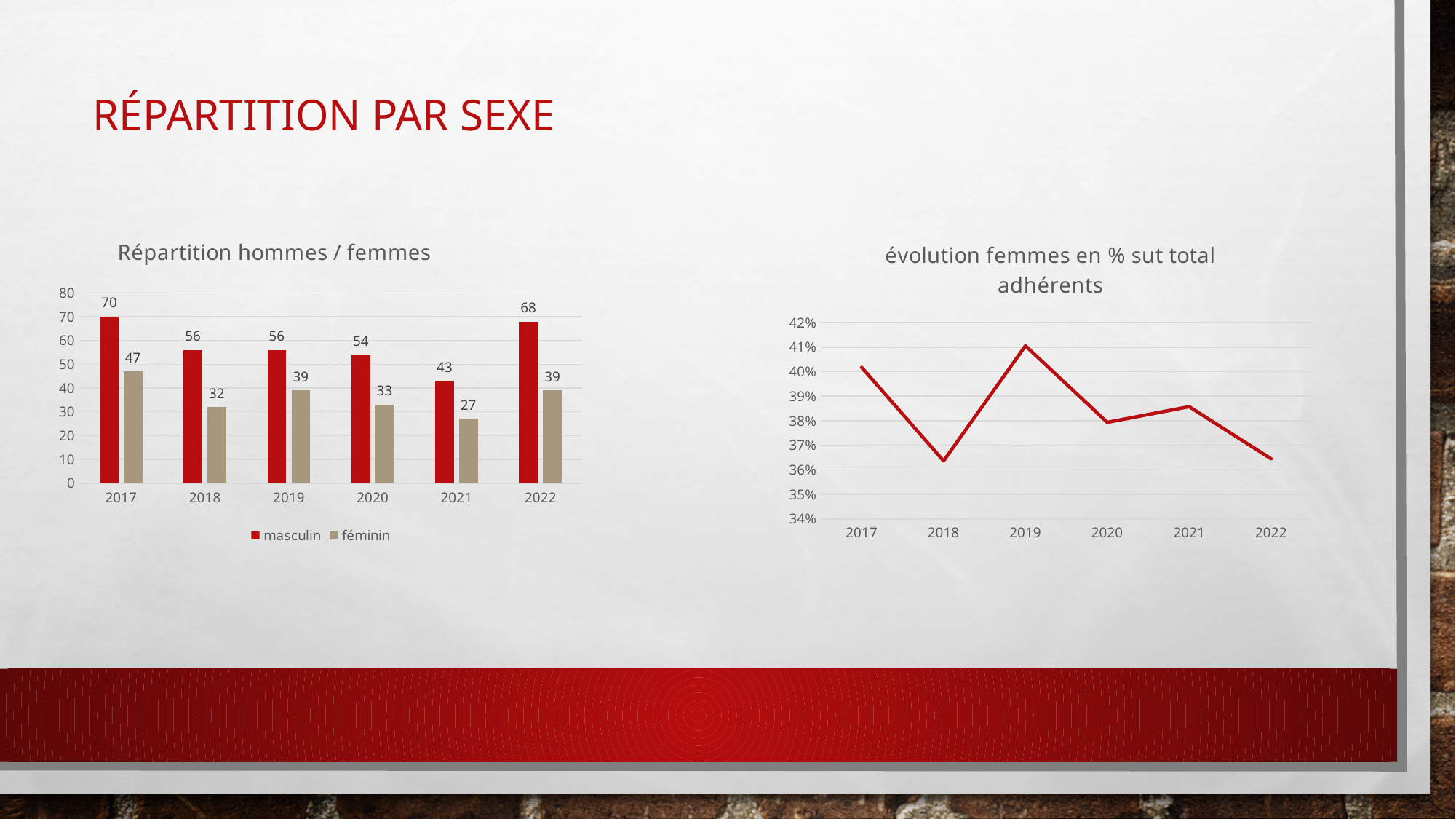
In the 'Répartition hommes / femmes' chart, how many series does the legend list? 2 In the 'évolution femmes en % sut total adhérents' chart, which year has the highest value? 2019 In the 'Répartition hommes / femmes' chart, what is the value for masculin in 2017? 70 In the 'Répartition hommes / femmes' chart, what is the value for féminin in 2021? 27 In the 'Répartition hommes / femmes' chart, which year has the lowest masculin value? 2021 In the 'Répartition hommes / femmes' chart, how many years are shown on the x axis? 6 In the 'Répartition hommes / femmes' chart, which is larger: féminin in 2019 or féminin in 2020? féminin in 2019 What kind of chart is 'évolution femmes en % sut total adhérents'? line chart In the 'évolution femmes en % sut total adhérents' chart, is the value for 2019 greater or less than 40%? greater In the 'évolution femmes en % sut total adhérents' chart, does the value rise or fall from 2019 to 2020? fall In the 'Répartition hommes / femmes' chart, what is the difference between masculin and féminin in 2022? 29 In the 'Répartition hommes / femmes' chart, which year has the highest féminin value? 2017